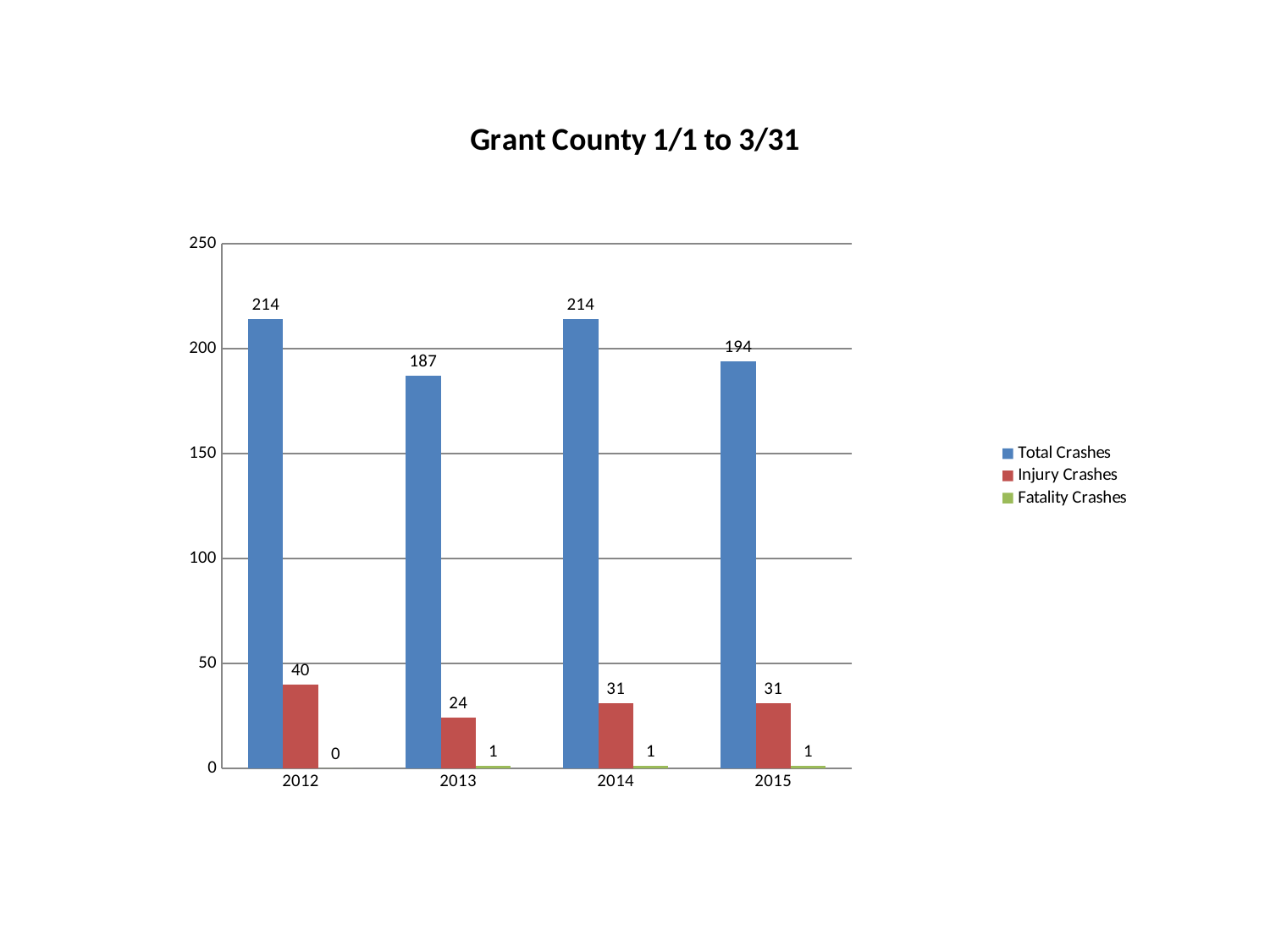
Which year has the lowest Total Crashes? 2013 Is the value of Total Crashes for 2015 greater or less than 200? less What is the difference between Injury Crashes in 2012 and 2013? 16 What is the difference between Total Crashes in 2012 and 2015? 20 What kind of chart is shown on the slide? bar chart What is the value of Total Crashes for 2013? 187 Which year has the highest Injury Crashes? 2012 What is the value of Injury Crashes for 2012? 40 How many series does the legend list? 3 What is the value of Fatality Crashes for 2014? 1 Which is larger, Total Crashes in 2013 or Total Crashes in 2015? 2015 How many years are shown on the x axis? 4